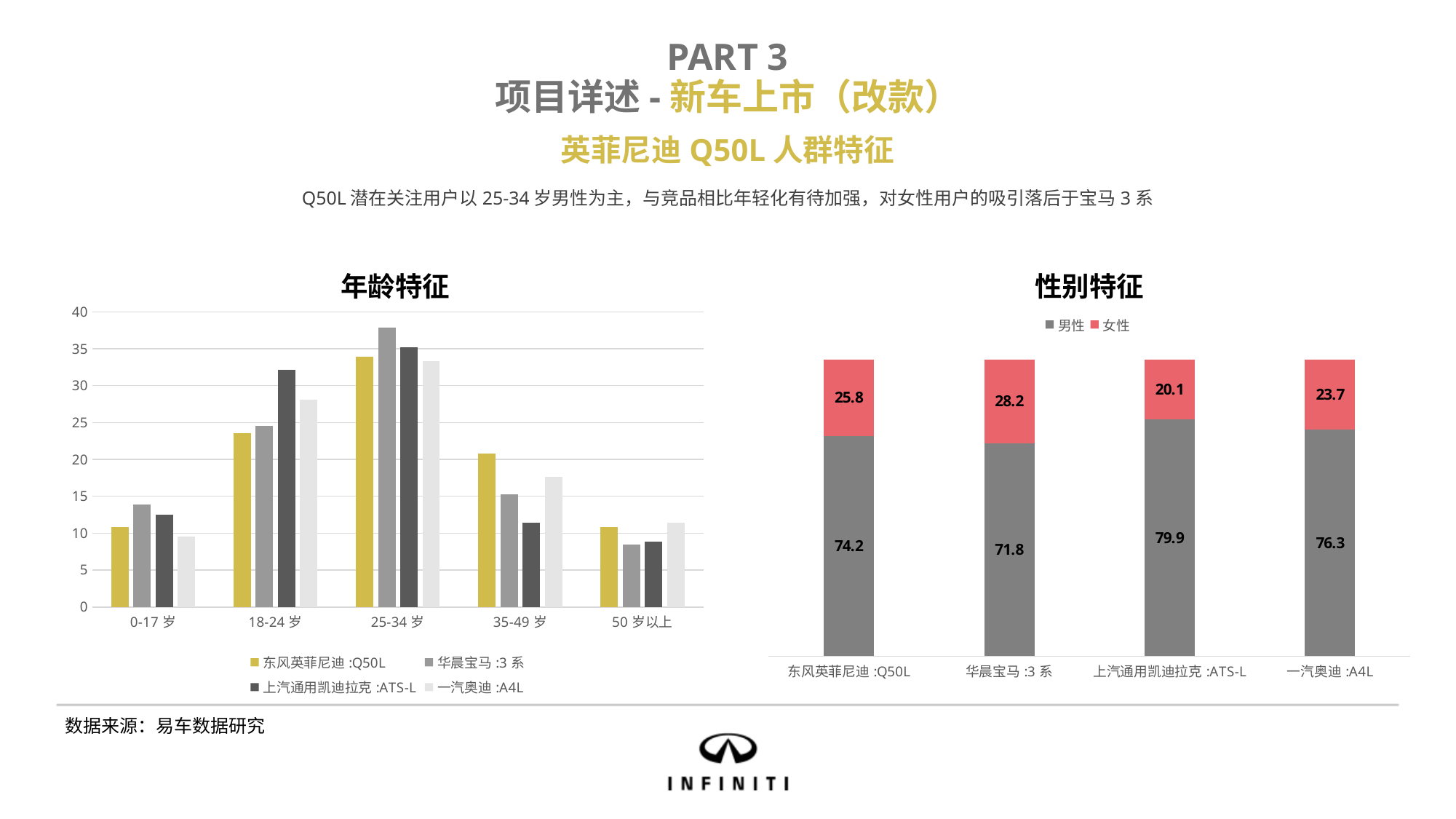
In the 性别特征 chart, what is the 男性 value for 东风英菲尼迪 :Q50L? 74.2 In the 性别特征 chart, which car has the lowest 女性 value? 上汽通用凯迪拉克 :ATS-L In the 性别特征 chart, what is the total of the stacked bar for 一汽奥迪 :A4L? 100 In the 年龄特征 chart, how many series does the legend list? 4 In the 性别特征 chart, what is the difference between the 女性 values of 华晨宝马 :3 系 and 东风英菲尼迪 :Q50L? 2.4 In the 年龄特征 chart, which age group has the highest value for 东风英菲尼迪 :Q50L? 25-34 岁 In the 性别特征 chart, what is the 女性 value for 华晨宝马 :3 系? 28.2 In the 年龄特征 chart, how many age categories are shown on the x axis? 5 What kind of chart is the 年龄特征 chart? bar chart In the 年龄特征 chart, is the value for 华晨宝马 :3 系 in the 25-34 岁 group greater or less than 35? greater In the 性别特征 chart, what is the 男性 value for 上汽通用凯迪拉克 :ATS-L? 79.9 In the 性别特征 chart, which car has the highest 女性 value? 华晨宝马 :3 系